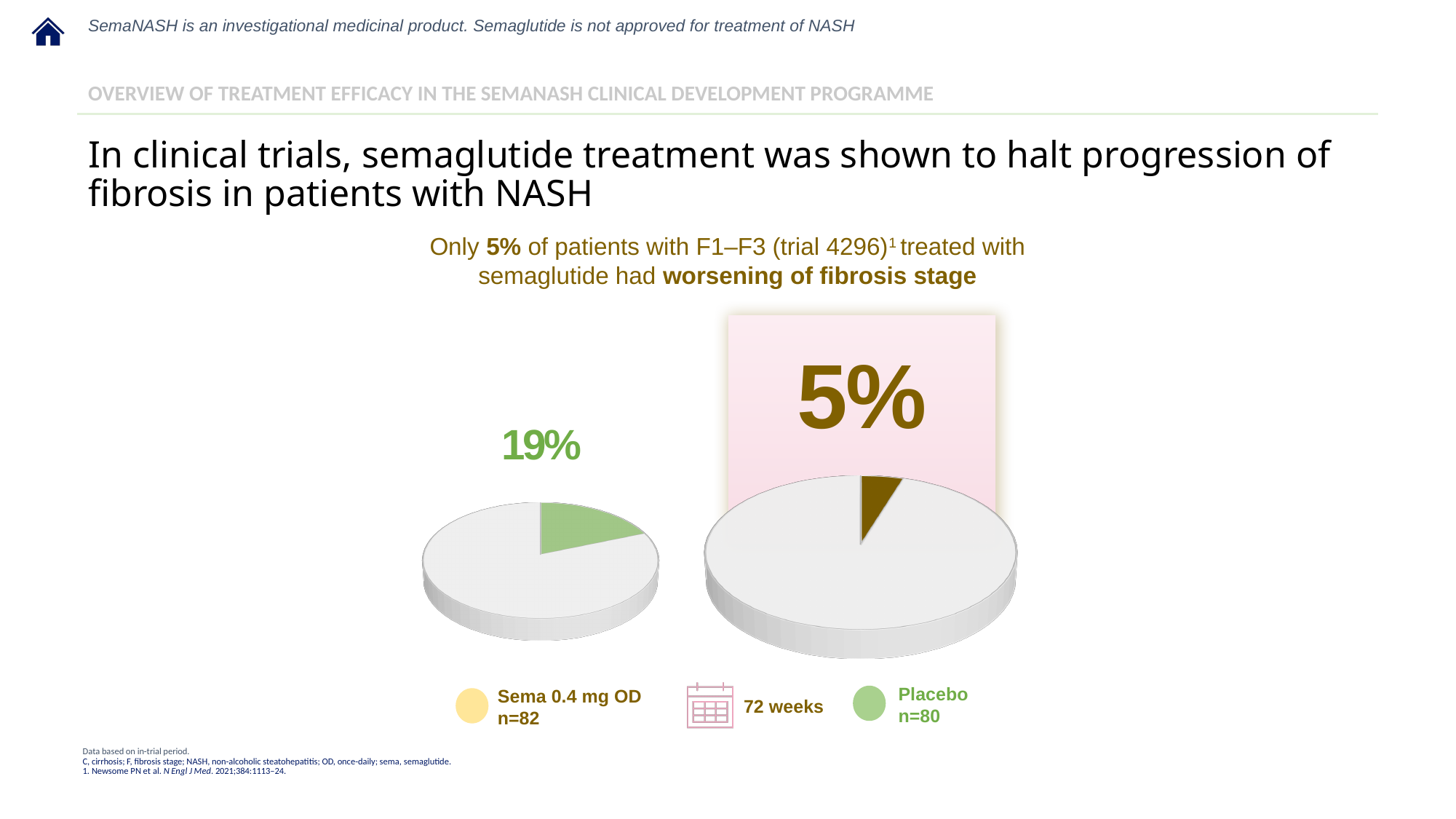
What share of the right pie chart does the highlighted (brown) slice represent? 5% What percentage of semaglutide-treated patients had worsening of fibrosis stage, as shown on the right pie chart? 5% Which group had the smaller share of patients with worsening of fibrosis stage? Sema 0.4 mg OD What share of the left pie chart does the green slice represent? 19% What treatment duration is indicated between the two pie charts? 72 weeks Which group had the larger share of patients with worsening of fibrosis stage, semaglutide or placebo? Placebo What kind of chart is used to show the worsening of fibrosis stage on this slide? Pie chart How many patients were in the placebo group according to the legend? n=80 What percentage of placebo-treated patients had worsening of fibrosis stage, as shown on the left pie chart? 19% How many pie charts are shown on the slide? 2 What is the difference in percentage points between the placebo (19%) and semaglutide (5%) worsening-of-fibrosis shares? 14 percentage points